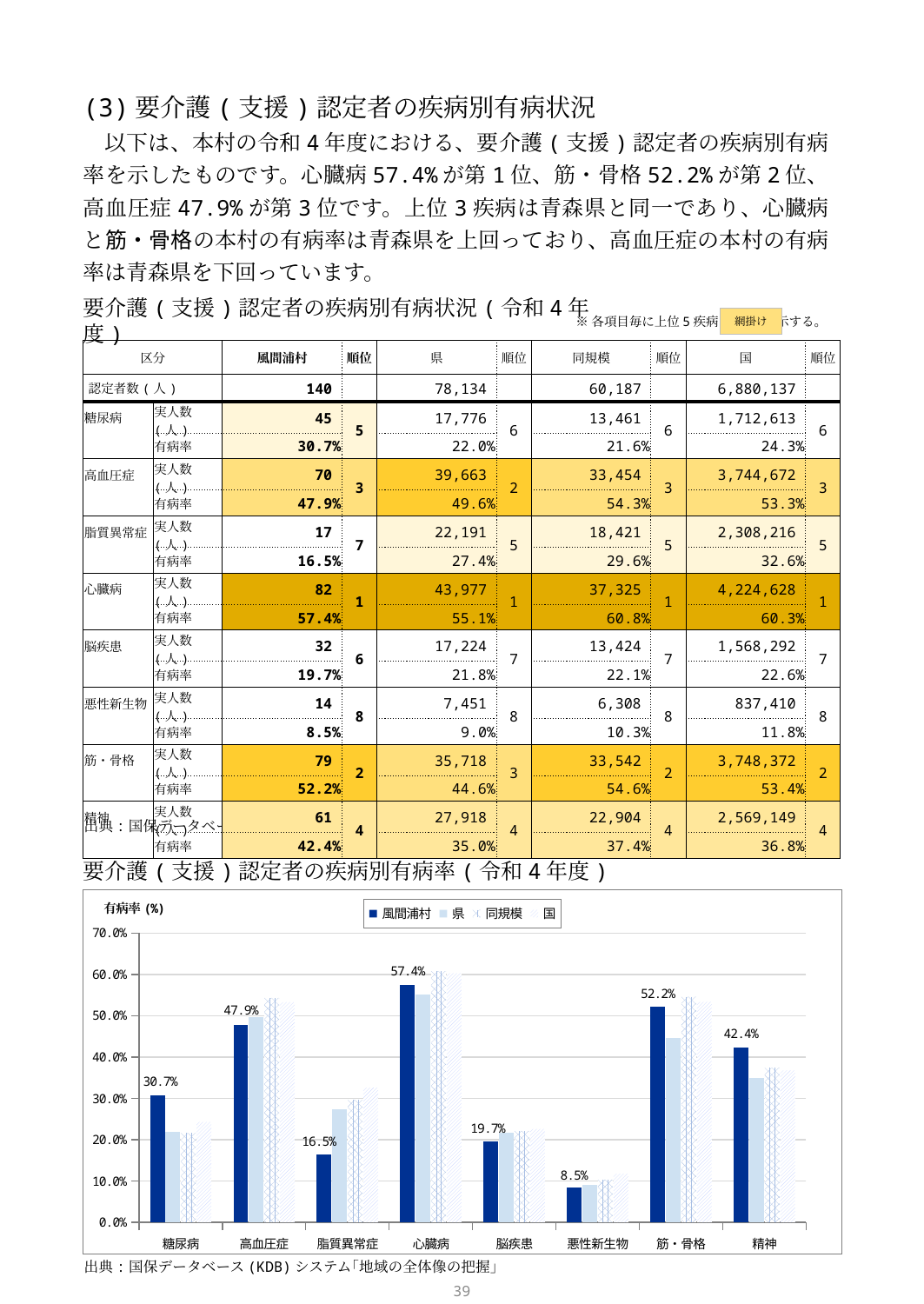
In the bar chart, which is larger for 風間浦村: 糖尿病 or 脳疾患? 糖尿病 In the bar chart, is the 県 value for 心臓病 greater or less than 50.0%? greater In the bar chart, which category has the highest 風間浦村 value? 心臓病 In the bar chart, what is the difference between the 風間浦村 values for 心臓病 and 高血圧症? 9.5% In the bar chart, what is the 風間浦村 value for 筋・骨格? 52.2% What type of chart is shown on the slide? bar chart How many categories are shown on the x axis of the bar chart? 8 In the bar chart, what is the 風間浦村 value for 心臓病? 57.4% In the bar chart, which category has the lowest 風間浦村 value? 悪性新生物 In the bar chart, what is the 風間浦村 value for 悪性新生物? 8.5% How many series does the legend of the bar chart list? 4 In the bar chart, is the 国 value for 悪性新生物 greater or less than 20.0%? less